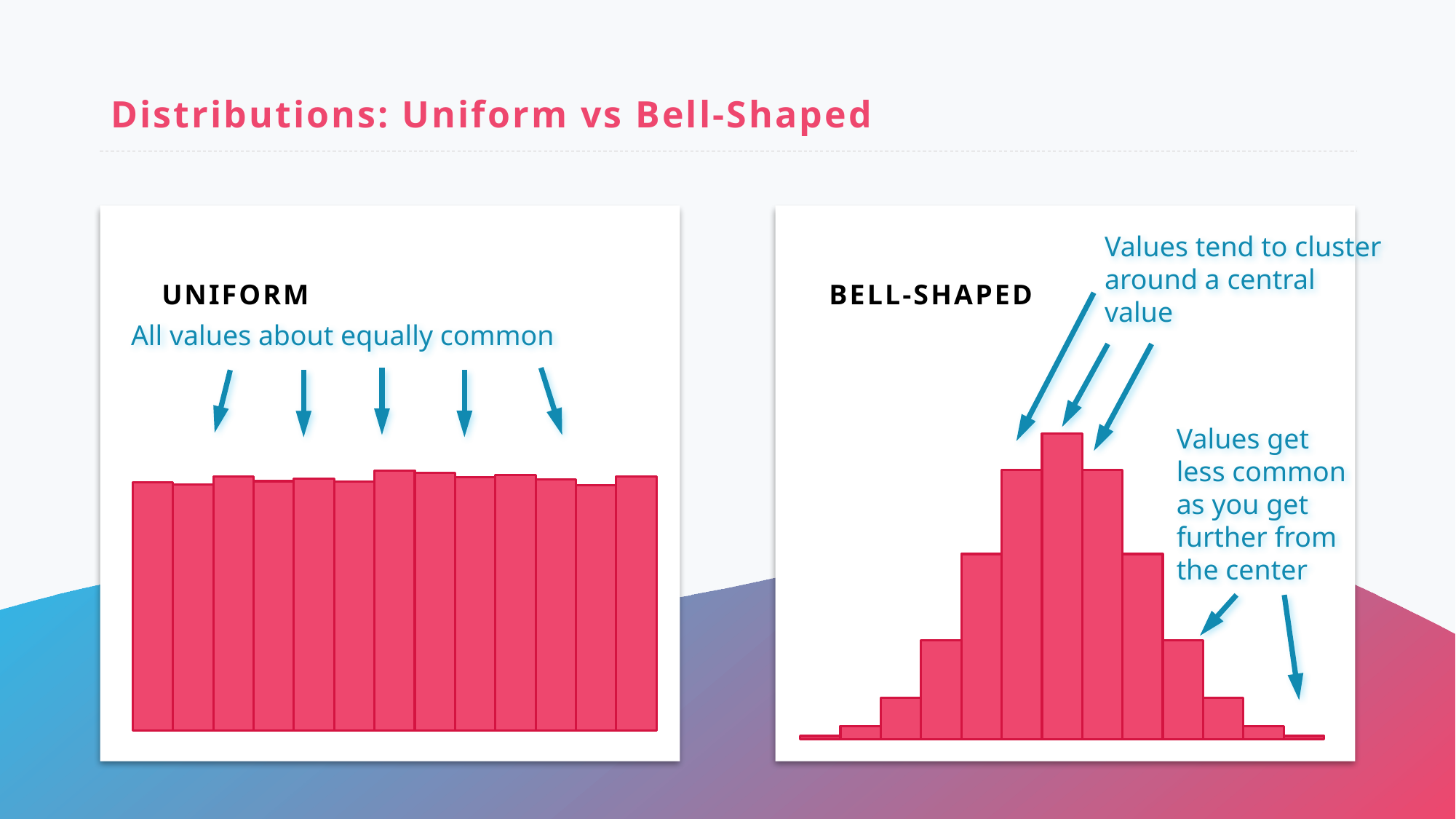
What kind of chart is shown in the UNIFORM panel on the left? bar chart How many bars are in the UNIFORM chart on the left? 13 In the BELL-SHAPED chart on the right, which bar is the tallest? the middle (7th) bar How many bars are in the BELL-SHAPED chart on the right? 13 In the BELL-SHAPED chart on the right, do the bar heights rise or fall moving from the left edge toward the center? rise What colour are the bars in both charts? pink/red In the UNIFORM chart on the left, do the bar heights show a clear rising or falling trend, or stay roughly level? stay roughly level In the BELL-SHAPED chart on the right, is the leftmost bar taller or shorter than the middle bar? shorter What kind of chart is shown in the BELL-SHAPED panel on the right? bar chart In the BELL-SHAPED chart on the right, do the bar heights rise or fall moving from the center toward the right edge? fall What is the title of the slide? Distributions: Uniform vs Bell-Shaped